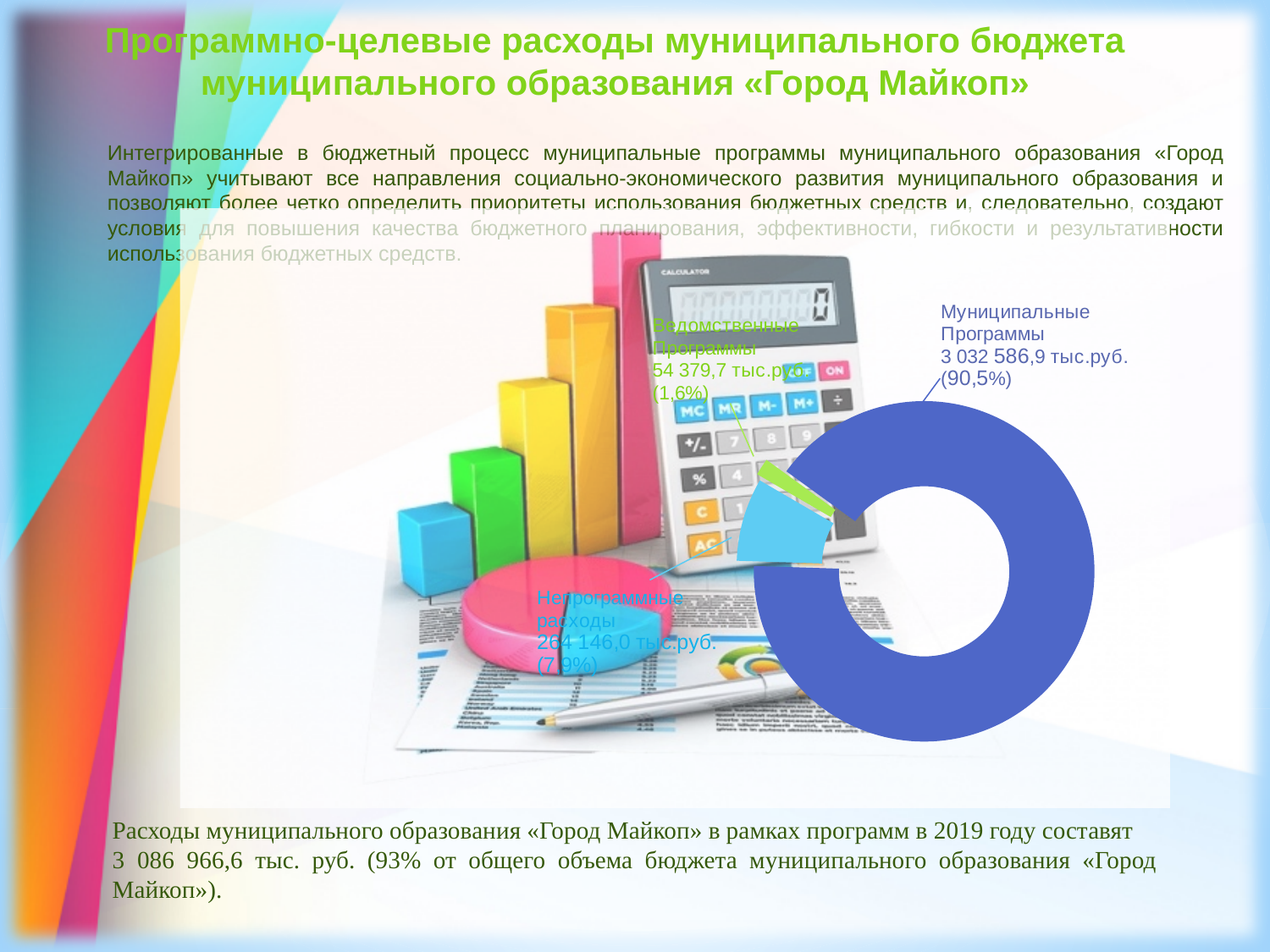
What is the value for Муниципальные Программы? 3 032 586,9 тыс.руб. Which segment of the doughnut chart is the smallest? Ведомственные Программы What share of the doughnut chart do Ведомственные Программы represent? 1,6% Which segment of the doughnut chart is the largest? Муниципальные Программы What is the value for Непрограммные расходы? 264 146,0 тыс.руб. What is the value for Ведомственные Программы? 54 379,7 тыс.руб. How many segments does the doughnut chart have? 3 Which is larger: Непрограммные расходы or Ведомственные Программы? Непрограммные расходы What share of the doughnut chart do Непрограммные расходы represent? 7,9% What kind of chart is shown on the slide? Doughnut (pie) chart What share of the doughnut chart do Муниципальные Программы represent? 90,5% What is the difference between Непрограммные расходы and Ведомственные Программы? 209 766,3 тыс.руб.